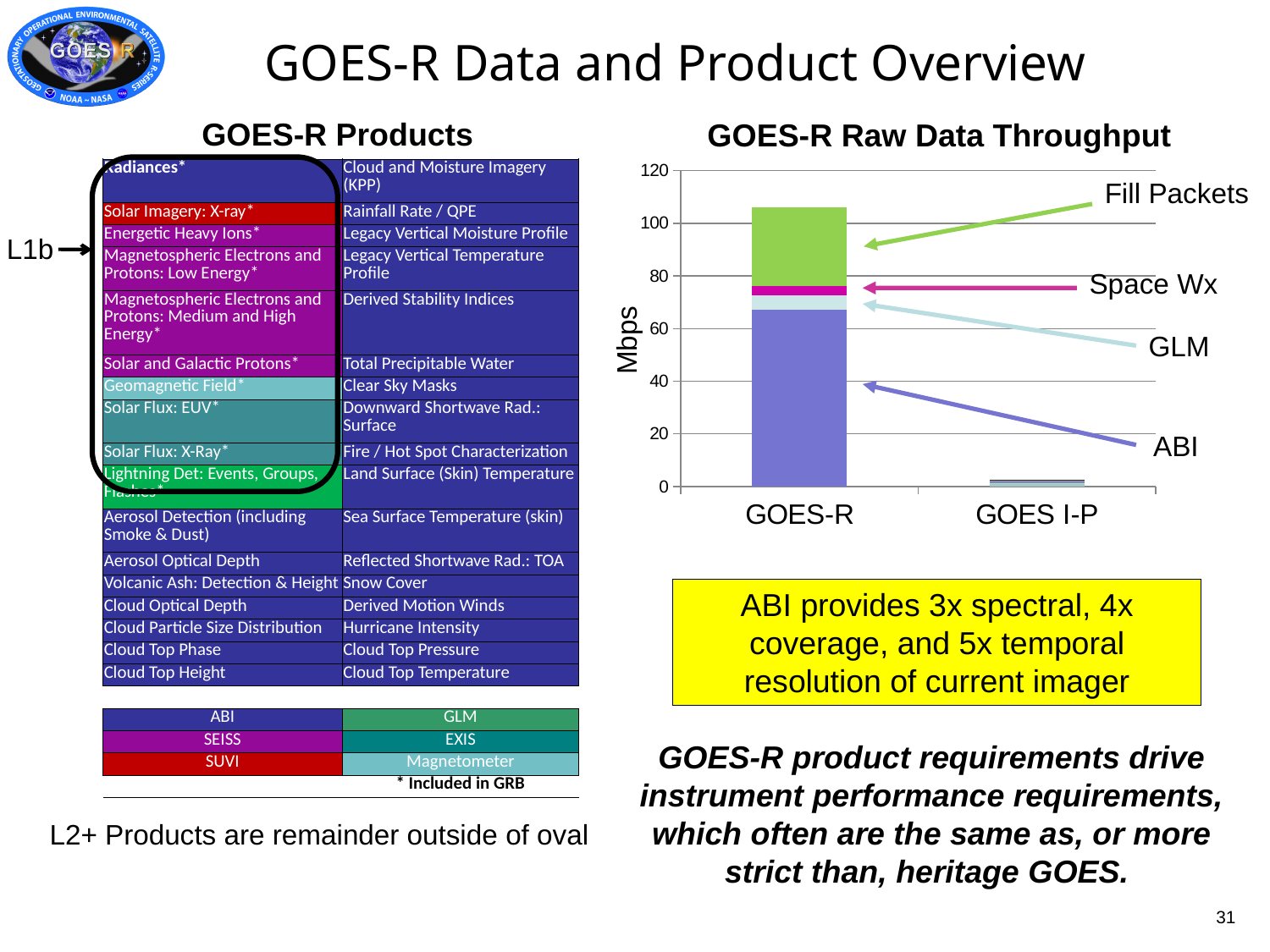
Which category has the higher total throughput in the GOES-R Raw Data Throughput chart? GOES-R What kind of chart is the GOES-R Raw Data Throughput chart? Stacked bar chart Which segment is labeled at the top of the GOES-R stacked bar? Fill Packets Is the ABI segment of the GOES-R bar greater or less than 80 Mbps? less Is the ABI segment of the GOES-R bar greater or less than 60 Mbps? greater Is the total throughput for GOES I-P greater or less than 20 Mbps? less Which segment makes up the largest part of the GOES-R bar? ABI Is the GOES-R bar taller or shorter than the GOES I-P bar? taller Which category has the lower total throughput in the GOES-R Raw Data Throughput chart? GOES I-P How many categories are shown on the x axis of the GOES-R Raw Data Throughput chart? 2 What is the y-axis label of the GOES-R Raw Data Throughput chart? Mbps